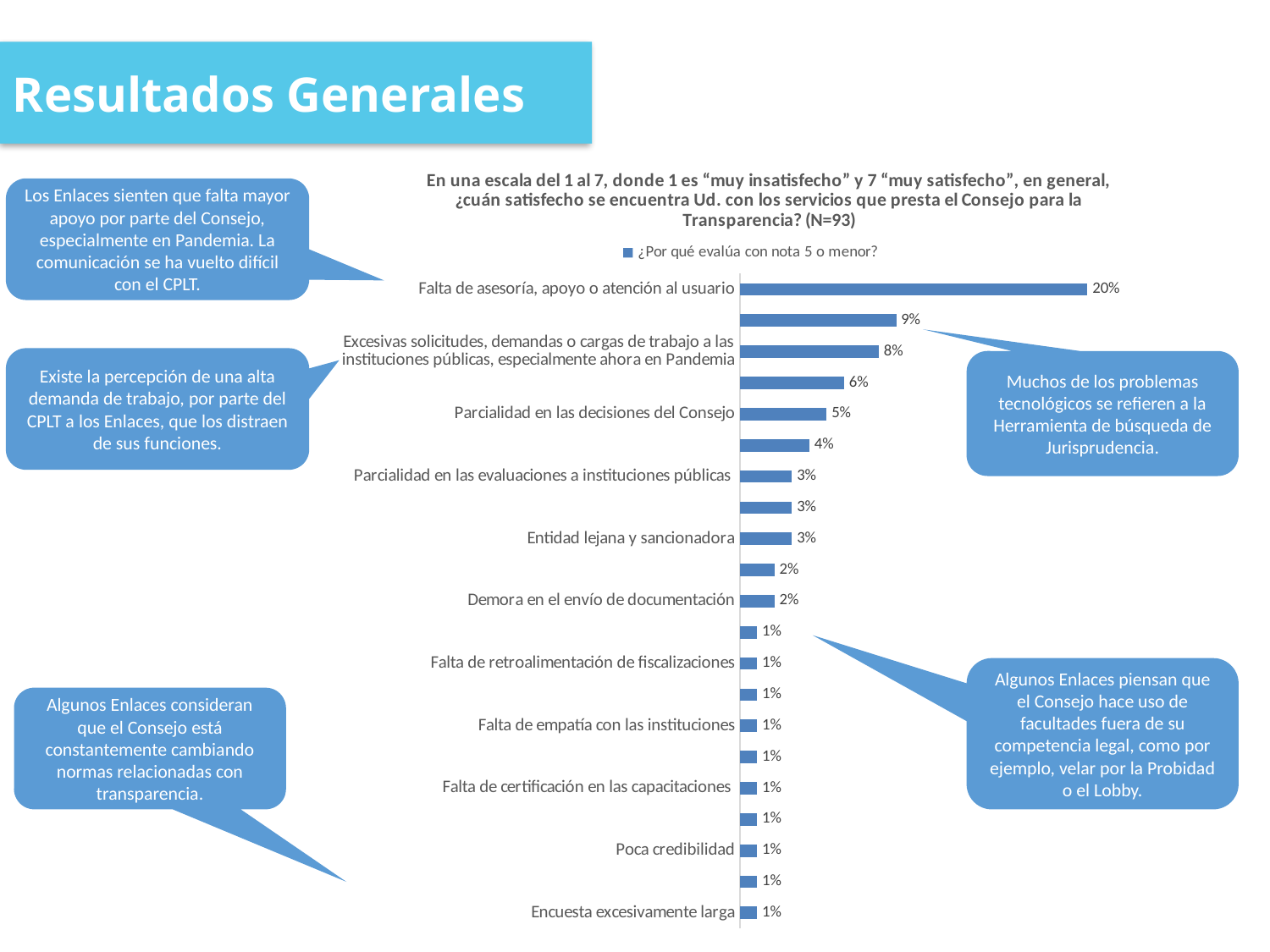
What value is shown for "Demora en el envío de documentación"? 2% What value is shown for "Falta de asesoría, apoyo o atención al usuario"? 20% What value is shown for "Poca credibilidad"? 1% How many series does the chart legend list? 1 What value is shown for "Excesivas solicitudes, demandas o cargas de trabajo a las instituciones públicas, especialmente ahora en Pandemia"? 8% What is the difference between the values for "Falta de asesoría, apoyo o atención al usuario" and "Excesivas solicitudes, demandas o cargas de trabajo a las instituciones públicas, especialmente ahora en Pandemia"? 12% What kind of chart is shown on the slide? Bar chart Which category has the highest value in the chart? Falta de asesoría, apoyo o atención al usuario Which is larger: the value for "Parcialidad en las decisiones del Consejo" or the value for "Entidad lejana y sancionadora"? Parcialidad en las decisiones del Consejo What is the lowest value shown in the chart? 1% What is the sample size (N) stated in the chart title? 93 What value is shown for "Parcialidad en las decisiones del Consejo"? 5%